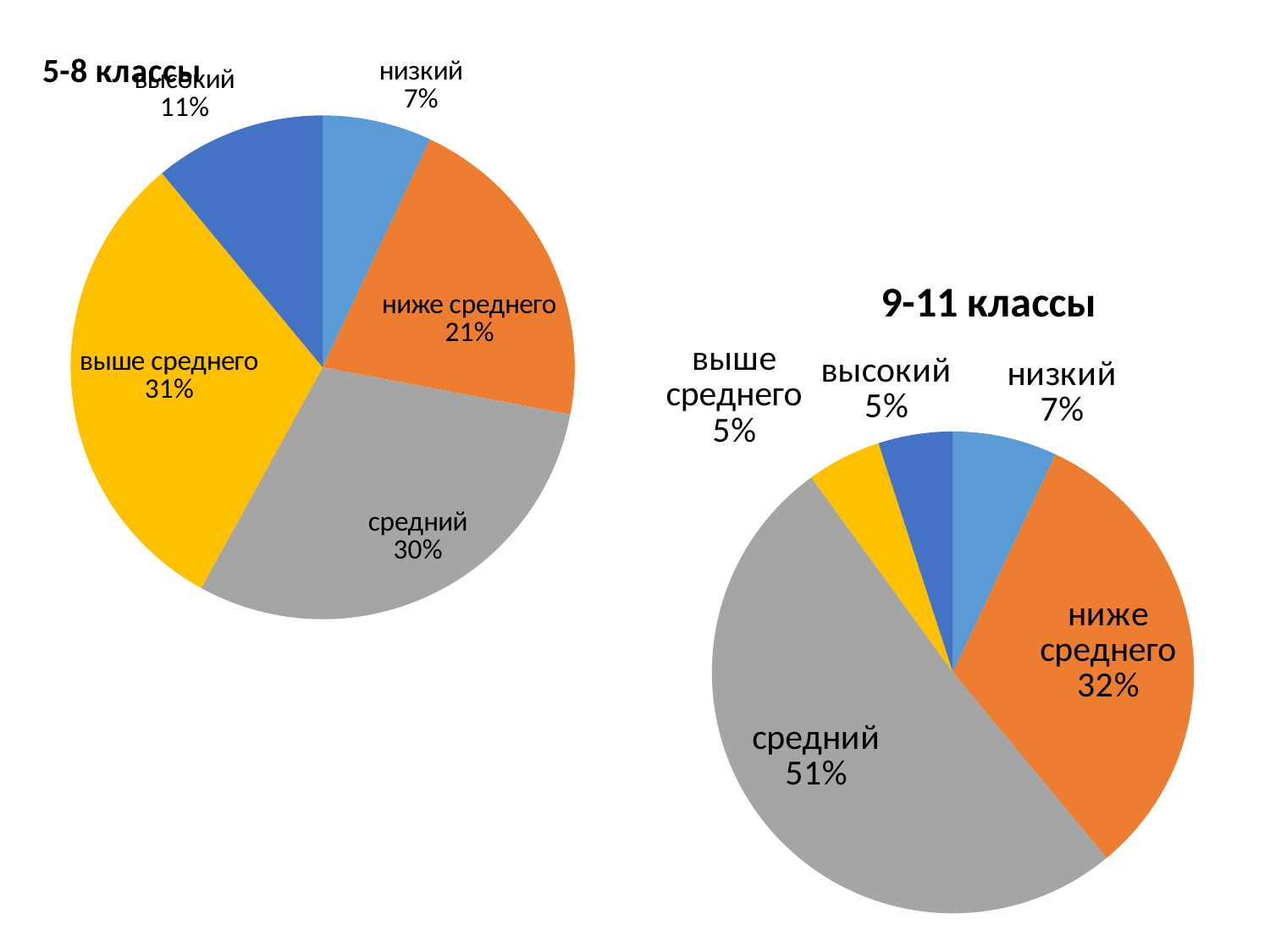
In the "5-8 классы" chart, which category has the smallest share? низкий In the "9-11 классы" chart, which category has the largest share? средний What colour is the "средний" slice in the "9-11 классы" chart? grey In the "9-11 классы" chart, what share does "средний" have? 51% In the "5-8 классы" chart, how many slices does the pie have? 5 In the "9-11 классы" chart, which is larger, "низкий" or "выше среднего"? низкий In the "9-11 классы" chart, what share does "ниже среднего" have? 32% In the "5-8 классы" chart, what is the difference between "выше среднего" and "ниже среднего"? 10% In the "9-11 классы" chart, what is the difference between "средний" and "ниже среднего"? 19% In the "5-8 классы" chart, what share does "высокий" have? 11% What type of chart is the "5-8 классы" chart? pie chart In the "5-8 классы" chart, what share does "средний" have? 30%